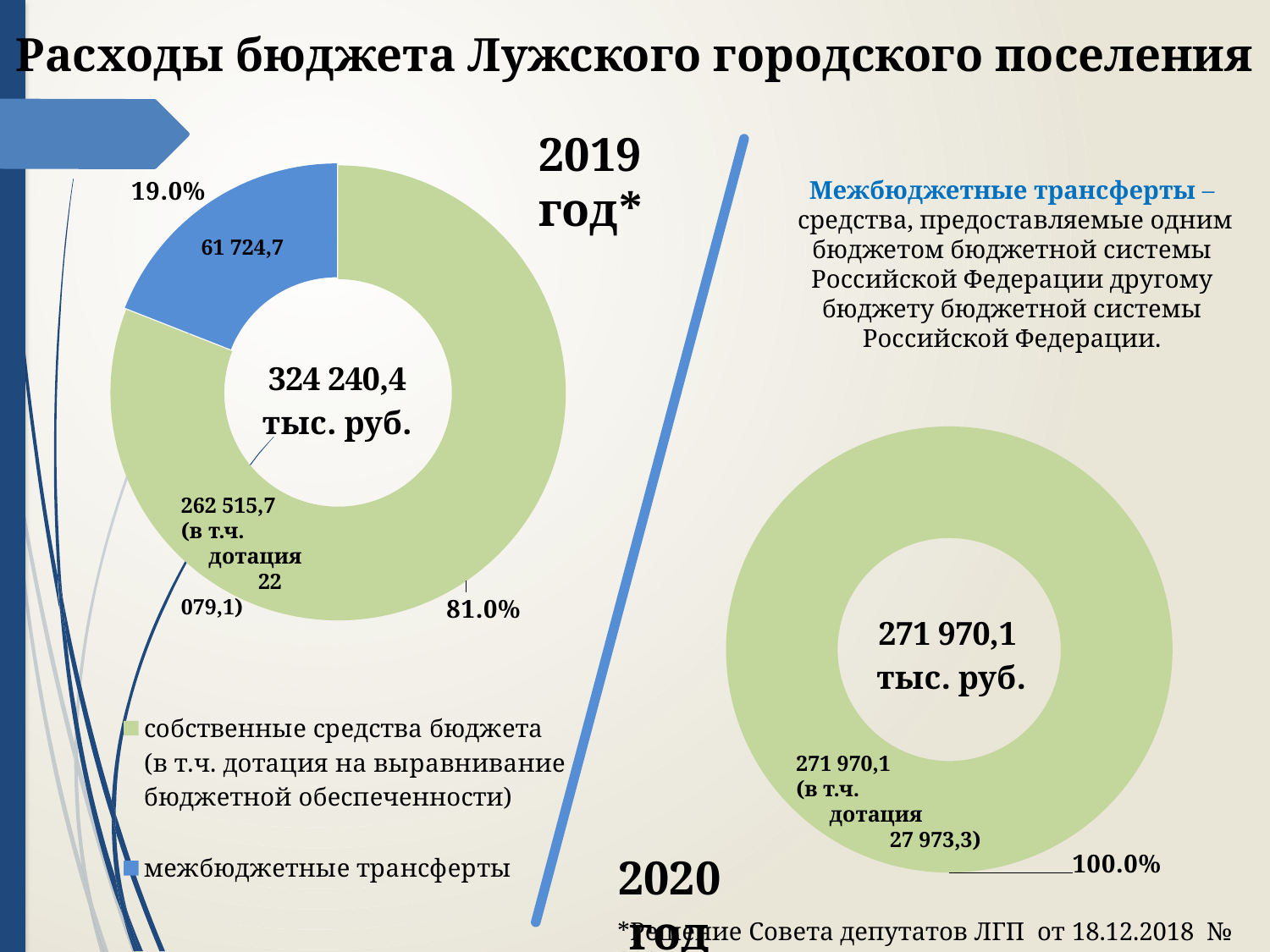
In the 2019 chart, what is the difference between собственные средства бюджета and межбюджетные трансферты? 200 791,0 How many entries does the legend of the 2019 chart list? 2 In the 2019 chart, which category is the largest? собственные средства бюджета In the 2019 chart, what is the value for межбюджетные трансферты? 61 724,7 In the 2019 chart, what is the value for собственные средства бюджета? 262 515,7 What is the total shown in the centre of the 2019 chart? 324 240,4 тыс. руб. What type of chart is used for the 2019 budget expenditures? doughnut chart In the 2019 chart, which category is the smallest? межбюджетные трансферты In the 2019 chart, what share of the total do собственные средства бюджета make up? 81.0% What is the total shown in the centre of the 2020 chart? 271 970,1 тыс. руб. In the 2020 chart, what share of the total do собственные средства бюджета make up? 100.0% In the 2019 chart, what share of the total do межбюджетные трансферты make up? 19.0%